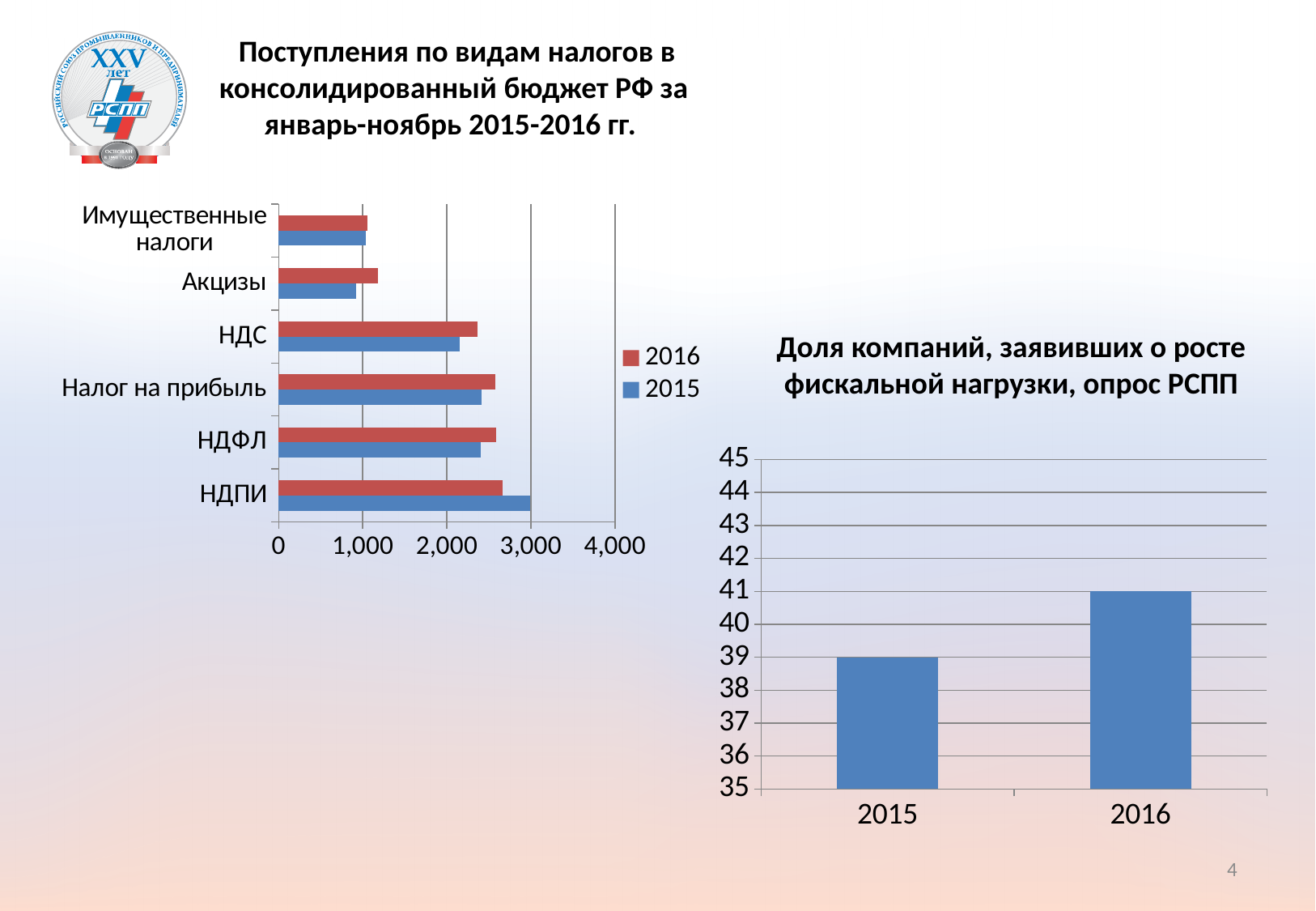
In the left chart, is the 2015 value for НДПИ greater or less than 2,000? greater In the right chart, 'Доля компаний, заявивших о росте фискальной нагрузки, опрос РСПП', what is the value for 2016? 41 In the left chart, how many tax categories are shown? 6 What kind of chart is the left chart, 'Поступления по видам налогов в консолидированный бюджет РФ за январь-ноябрь 2015-2016 гг.'? bar chart In the left chart, which colour represents 2016 in the legend? red In the left chart, which year has the larger value for НДПИ, 2015 or 2016? 2015 In the left chart, which category has the highest 2015 value? НДПИ In the right chart, 'Доля компаний, заявивших о росте фискальной нагрузки, опрос РСПП', by how much does the value for 2016 exceed the value for 2015? 2 In the left chart, how many series does the legend list? 2 In the left chart, which year has the larger value for Акцизы, 2015 or 2016? 2016 In the left chart, is the 2015 value for Акцизы greater or less than 1,000? less In the right chart, 'Доля компаний, заявивших о росте фискальной нагрузки, опрос РСПП', what is the value for 2015? 39